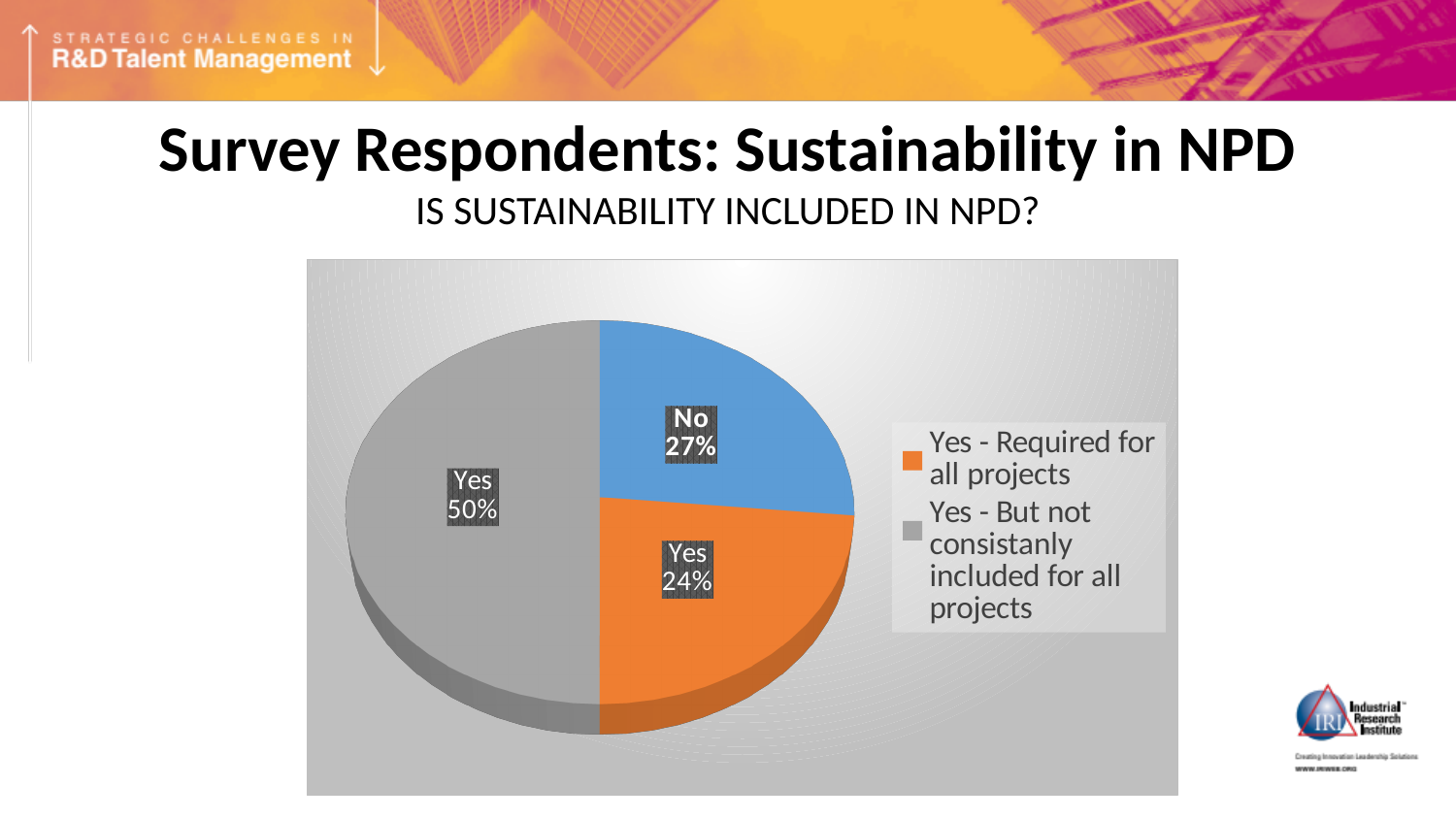
How many slices does the pie chart have? 3 What percentage is shown for the gray "Yes" slice? 50% What is the combined percentage of the two "Yes" slices? 74% What kind of chart is shown on the slide? Pie chart Which slice of the pie is the smallest? Yes 24% What percentage is shown for the orange "Yes" slice? 24% What question is the chart answering, according to the subtitle above it? IS SUSTAINABILITY INCLUDED IN NPD? What percentage of respondents answered "No"? 27% Which slice of the pie is the largest? Yes 50% Which is larger, the "No" slice or the orange "Yes" slice? No What is the difference in percentage points between the 50% "Yes" slice and the "No" slice? 23 Which legend entry corresponds to the orange slice? Yes - Required for all projects